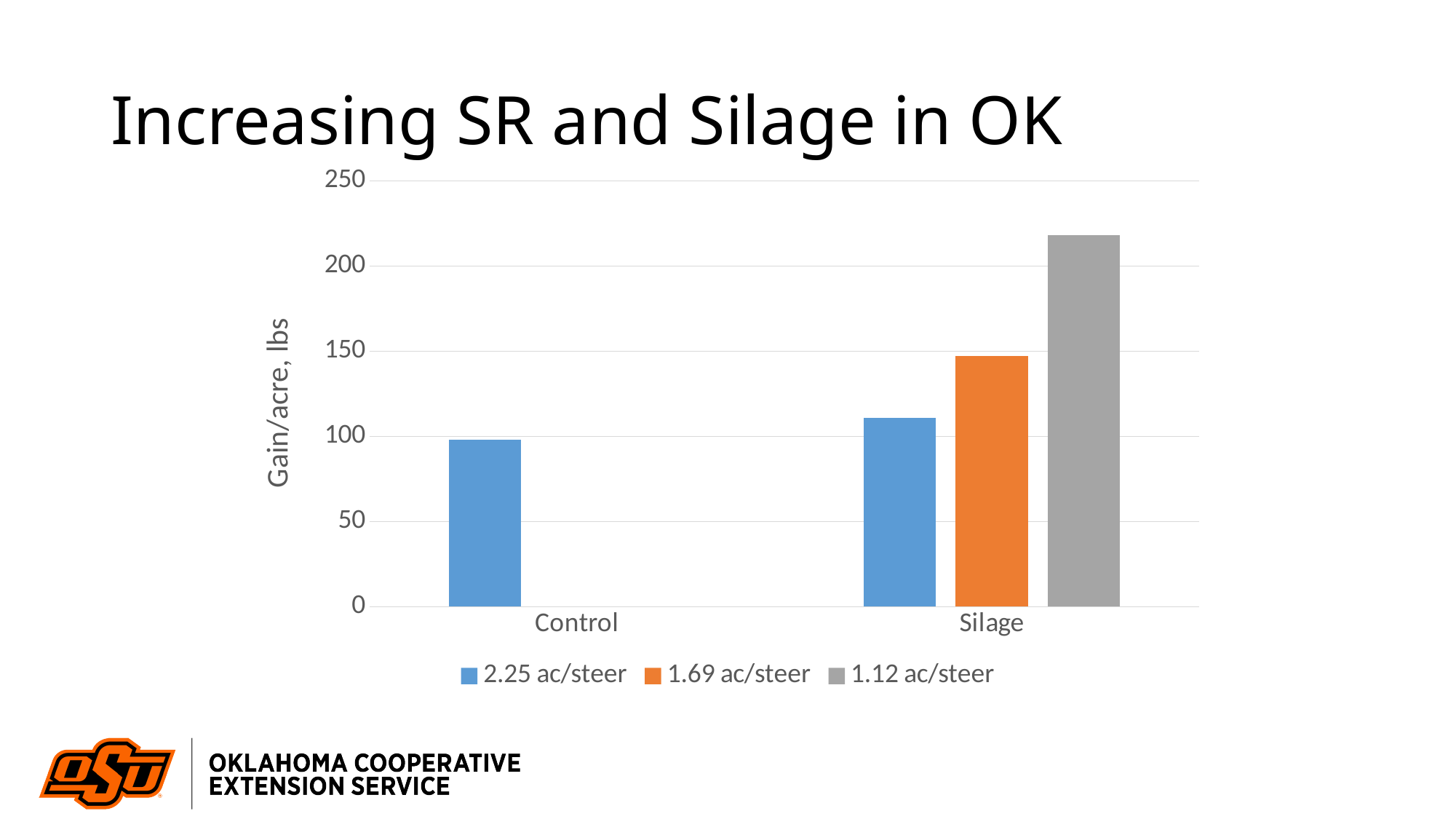
How many series does the legend list? 3 Which bar is the lowest in the chart? 2.25 ac/steer for Control Which is larger: the 2.25 ac/steer bar for Control or the 2.25 ac/steer bar for Silage? 2.25 ac/steer for Silage How many categories are shown on the x axis? 2 Is the value for 1.12 ac/steer under Silage greater or less than 200? greater Which bar is the highest in the chart? 1.12 ac/steer for Silage Is the value for 2.25 ac/steer under Silage greater or less than 100? greater Is the value for 2.25 ac/steer under Control greater or less than 150? less What kind of chart is shown on the slide? bar chart What is the label of the y axis? Gain/acre, lbs Which is larger under Silage: 1.69 ac/steer or 1.12 ac/steer? 1.12 ac/steer